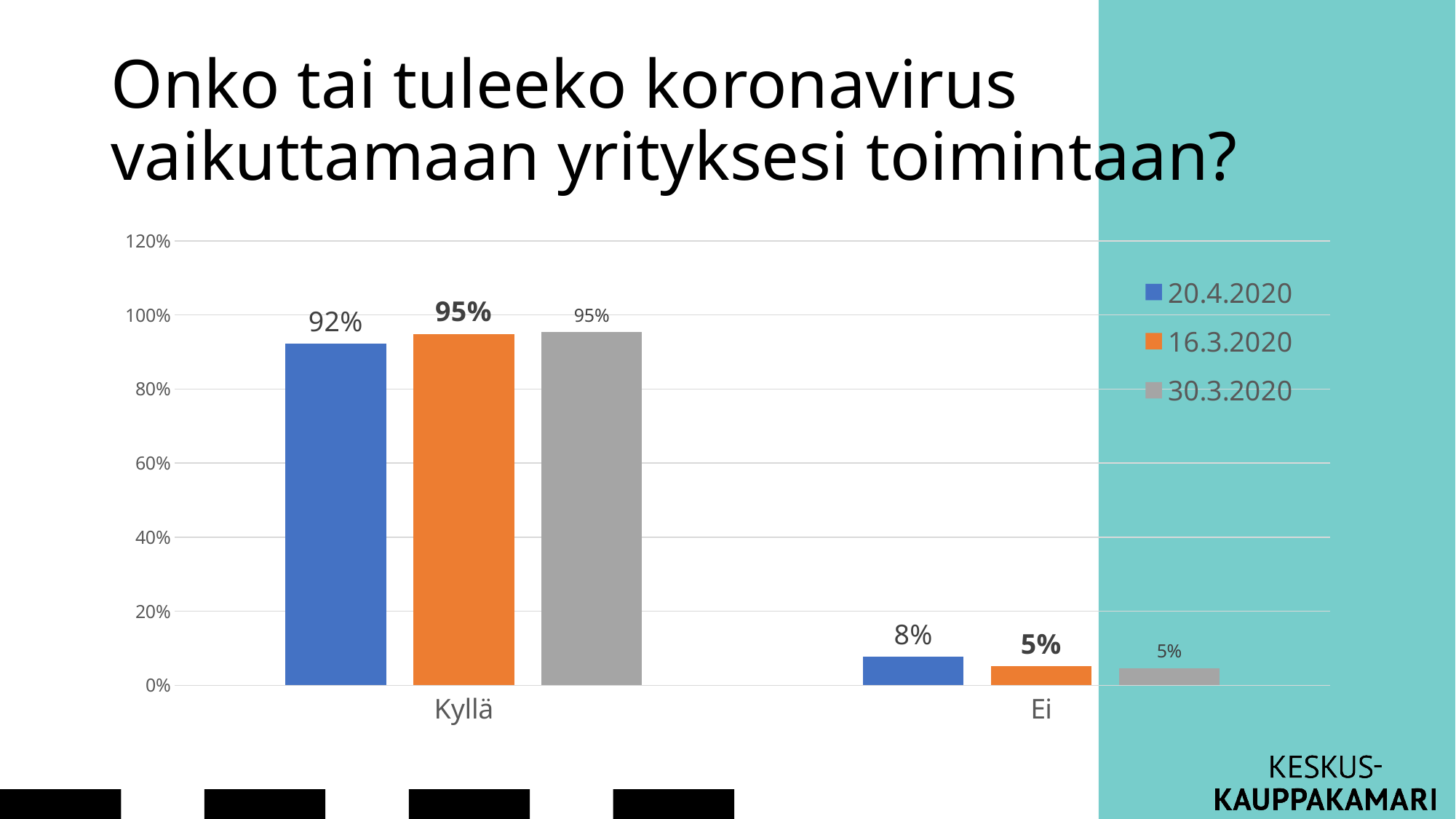
What is the value for Kyllä in the 30.3.2020 series? 95% Which is larger: the Ei value for 20.4.2020 or the Ei value for 30.3.2020? 20.4.2020 Which category has the highest value in the 16.3.2020 series? Kyllä How many series does the legend list? 3 What is the value for Ei in the 16.3.2020 series? 5% What is the value for Kyllä in the 20.4.2020 series? 92% Which category has the lowest value in the 30.3.2020 series? Ei How many categories are shown on the x axis? 2 What kind of chart is shown on the slide? bar chart What is the value for Ei in the 20.4.2020 series? 8% Is the value for Kyllä in the 20.4.2020 series greater or less than 80%? greater What is the difference between the Kyllä values for 16.3.2020 and 20.4.2020? 3%